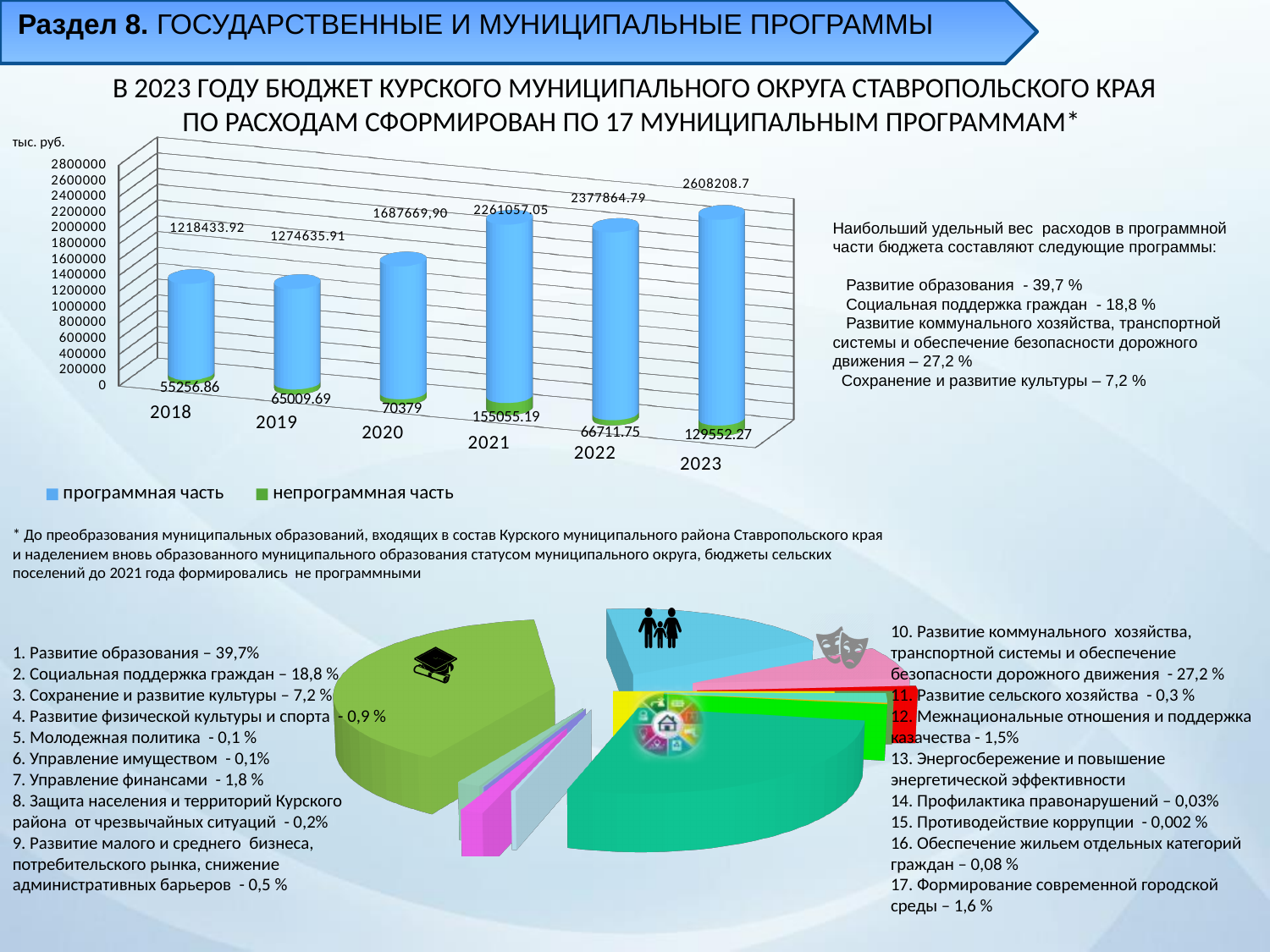
In the top bar chart, does the программная часть value rise or fall from 2018 to 2023? rises In the top bar chart, which year has the highest value for непрограммная часть? 2021 In the top bar chart, which year has the lowest value for непрограммная часть? 2018 What kind of chart is the top chart on the slide? bar chart How many series does the legend of the top bar chart list? 2 In the top bar chart, what is the value of программная часть for 2023? 2608208.7 In the top bar chart, which year has the highest value for программная часть? 2023 In the top bar chart, what is the value of непрограммная часть for 2021? 155055.19 In the top bar chart, what is the difference between the программная часть values for 2023 and 2022? 230343.91 In the top bar chart, which is larger: непрограммная часть for 2021 or for 2023? 2021 How many years are shown on the x axis of the top bar chart? 6 In the top bar chart, what is the value of программная часть for 2020? 1687669,90